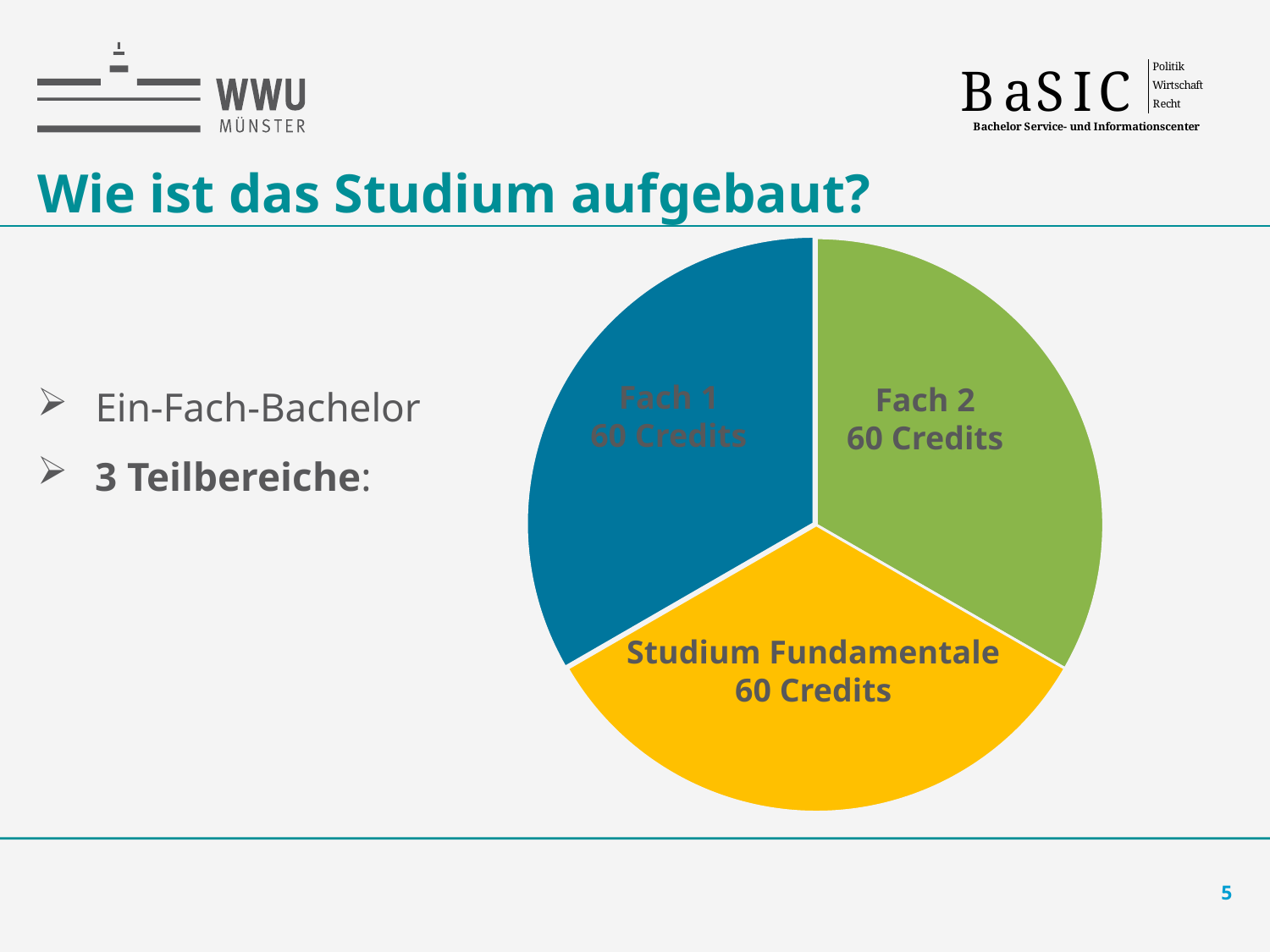
Which slice of the pie chart is coloured yellow? Studium Fundamentale What share of the pie chart does Fach 2 represent? one third What kind of chart is shown on the slide? pie chart What is the total number of credits across all three slices of the pie chart? 180 Credits Is the value for Studium Fundamentale greater or less than 100 Credits? less Is the value for Fach 1 greater or less than 50 Credits? greater Which slice of the pie chart is coloured green? Fach 2 How many credits are shown for Studium Fundamentale in the pie chart? 60 Credits How many slices does the pie chart have? 3 How many credits are shown for Fach 2 in the pie chart? 60 Credits How many credits are shown for Fach 1 in the pie chart? 60 Credits What share of the pie chart does Studium Fundamentale represent? one third